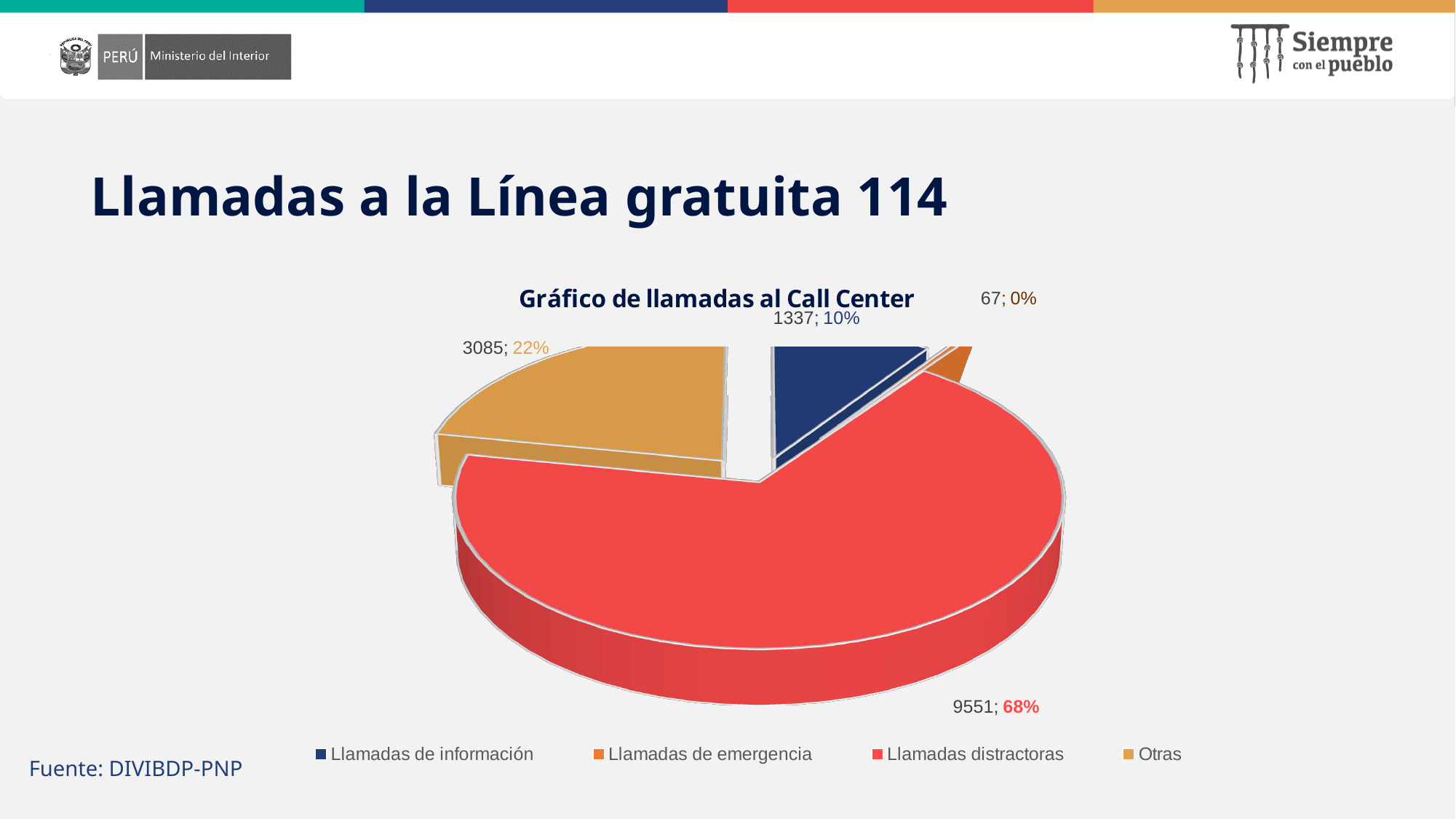
Which category has the smallest slice? Llamadas de emergencia What kind of chart is shown on the slide? Pie chart How many calls are labelled for Llamadas de emergencia? 67 Which category has the largest slice? Llamadas distractoras What share of the pie is Llamadas distractoras? 68% What is the difference in calls between Otras and Llamadas de información? 1748 How many calls are labelled for Llamadas de información? 1337 What share of the pie is Otras? 22% How many calls are labelled for Otras? 3085 How many categories does the legend list? 4 What is the title of the chart? Gráfico de llamadas al Call Center How many calls are labelled for Llamadas distractoras? 9551